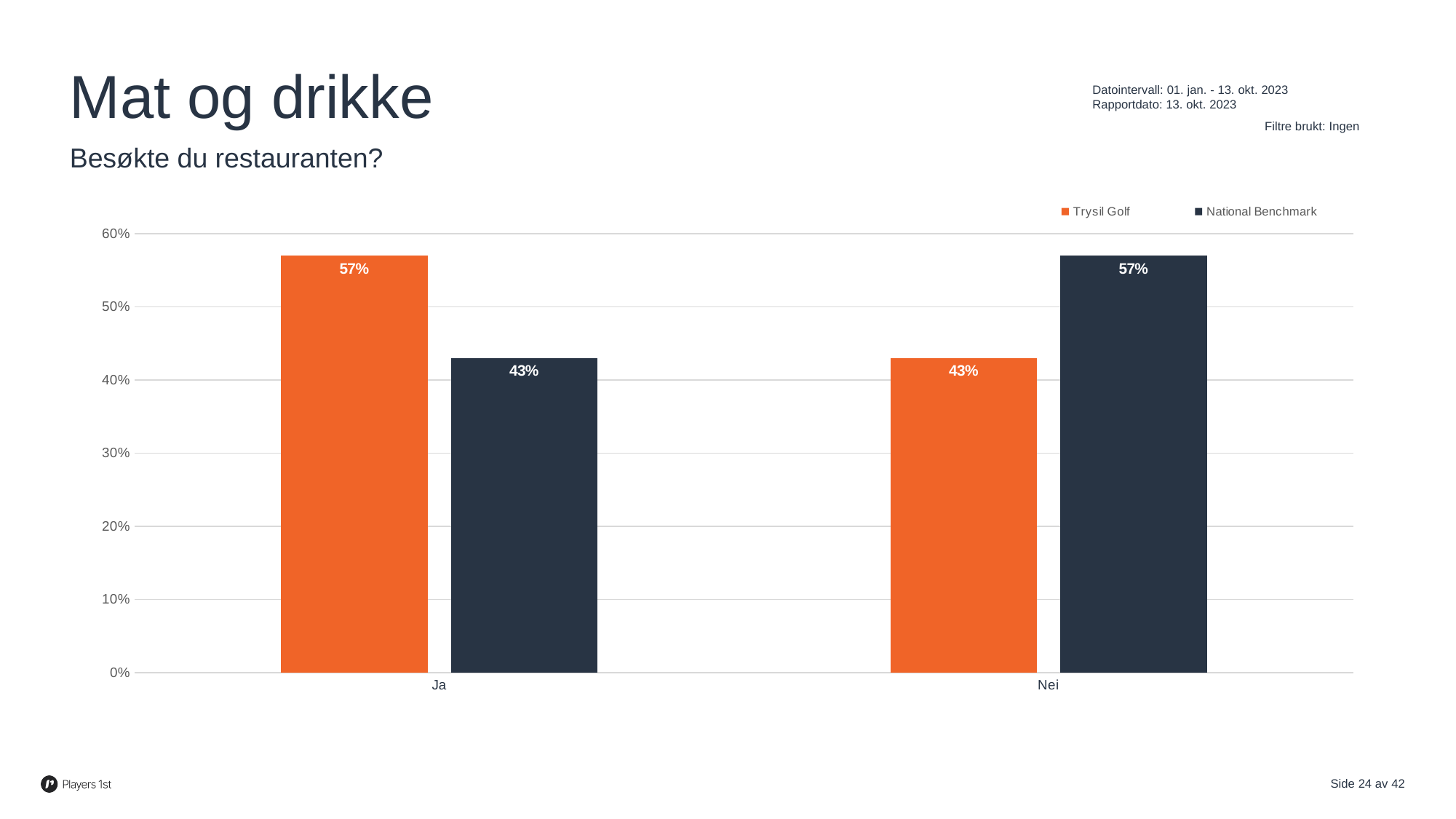
In the Nei category, which series has the larger value, Trysil Golf or National Benchmark? National Benchmark In the Ja category, which series has the larger value, Trysil Golf or National Benchmark? Trysil Golf What is the value for Trysil Golf in the Ja category? 57% What is the value for National Benchmark in the Ja category? 43% How many series does the legend list? 2 How many categories are shown on the x axis? 2 Which category has the highest value for Trysil Golf? Ja What kind of chart is shown on the slide? Bar chart What is the difference between Trysil Golf and National Benchmark in the Ja category? 14% What is the value for Trysil Golf in the Nei category? 43% What is the value for National Benchmark in the Nei category? 57% Which category has the lowest value for National Benchmark? Ja